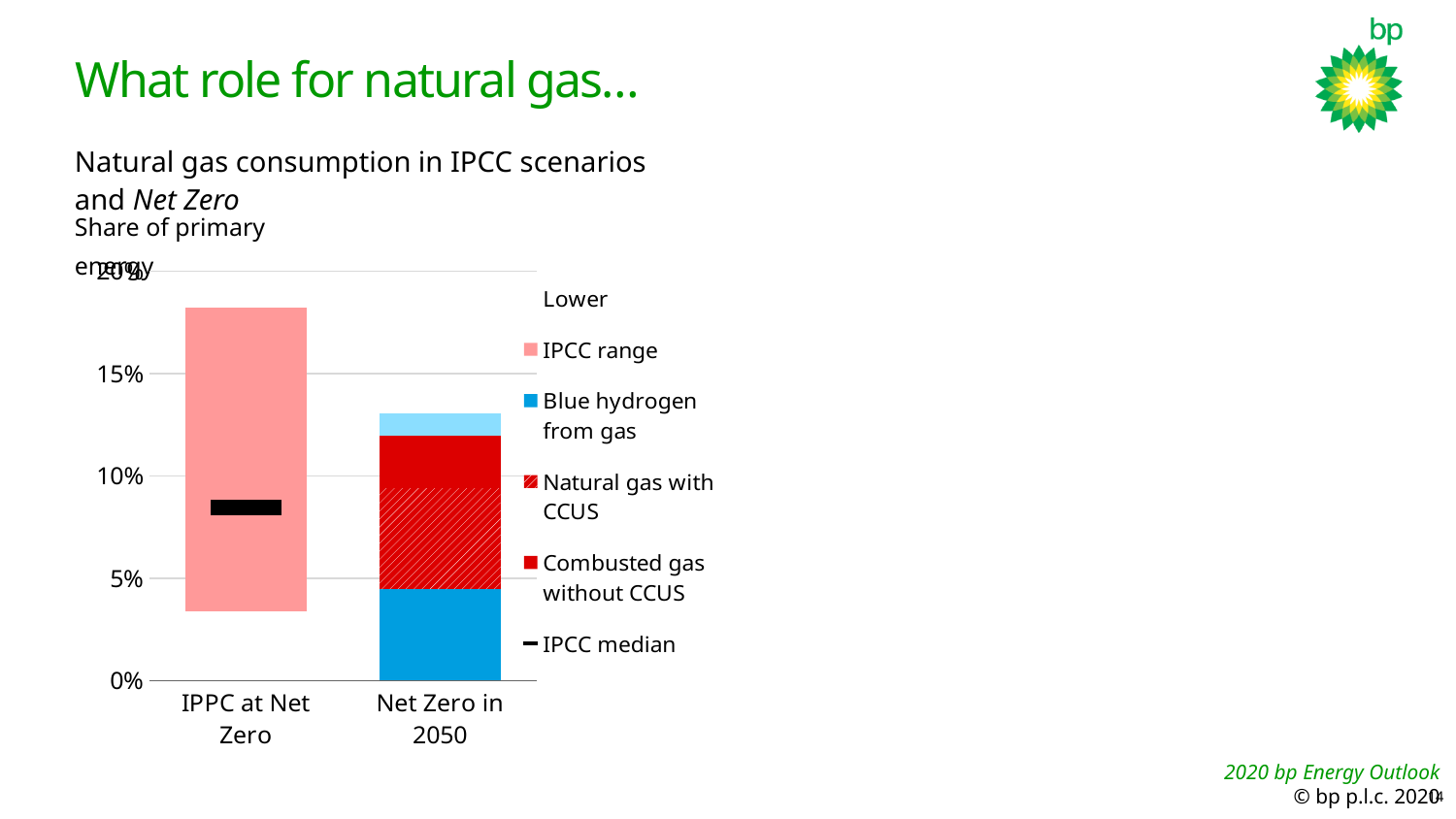
Which is larger: the IPCC median value or the total of the 'Net Zero in 2050' stacked bar? The total of the Net Zero in 2050 bar What type of chart is shown on the slide? Bar chart Is the top of the IPCC range bar for 'IPPC at Net Zero' greater or less than 15%? greater Is the 'Blue hydrogen from gas' segment in the 'Net Zero in 2050' bar greater or less than 5%? less Is the total height of the stacked bar for 'Net Zero in 2050' greater or less than 15%? less How many categories are shown on the x axis of the chart? 2 What is the title of the chart? Natural gas consumption in IPCC scenarios and Net Zero What is the highest value shown on the y axis of the chart? 20% Which reaches higher on the axis: the top of the IPCC range bar or the top of the 'Net Zero in 2050' stacked bar? The top of the IPCC range bar